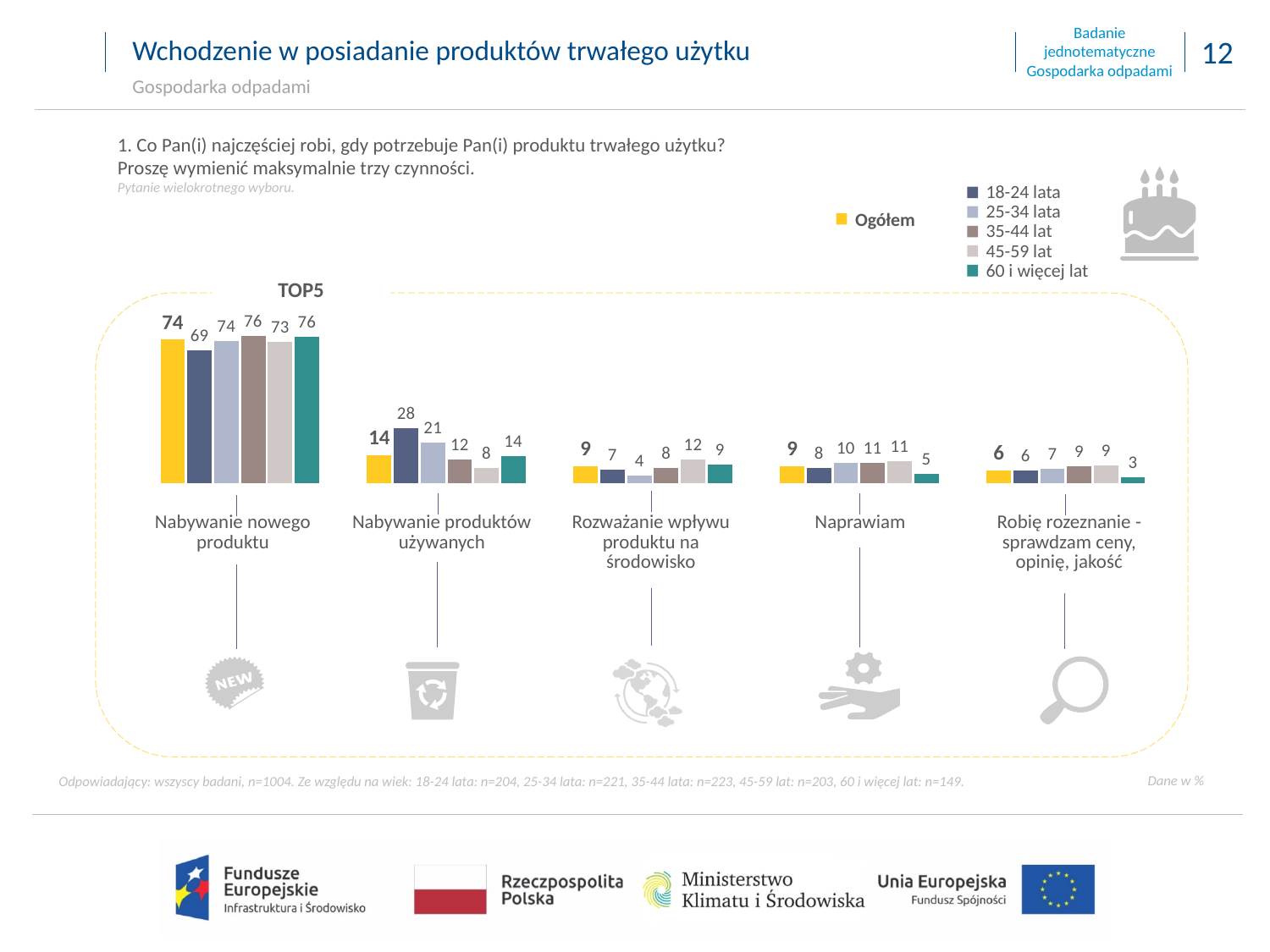
What kind of chart is shown on the slide? Bar chart What is the value for the 60 i więcej lat group for "Robię rozeznanie - sprawdzam ceny, opinię, jakość"? 3 What is the Ogółem value for "Nabywanie nowego produktu"? 74 What is the difference between the 18-24 lata value and the 45-59 lat value for "Nabywanie produktów używanych"? 20 How many series does the legend list? 6 Which series is shown in yellow in the chart? Ogółem Which category has the highest Ogółem value? Nabywanie nowego produktu What is the value for the 18-24 lata group for "Nabywanie produktów używanych"? 28 Which category has the lowest Ogółem value? Robię rozeznanie - sprawdzam ceny, opinię, jakość What is the value for the 45-59 lat group for "Rozważanie wpływu produktu na środowisko"? 12 For "Naprawiam", which is larger: the value for 35-44 lat or the value for 60 i więcej lat? 35-44 lat How many categories are shown on the x axis of the chart? 5